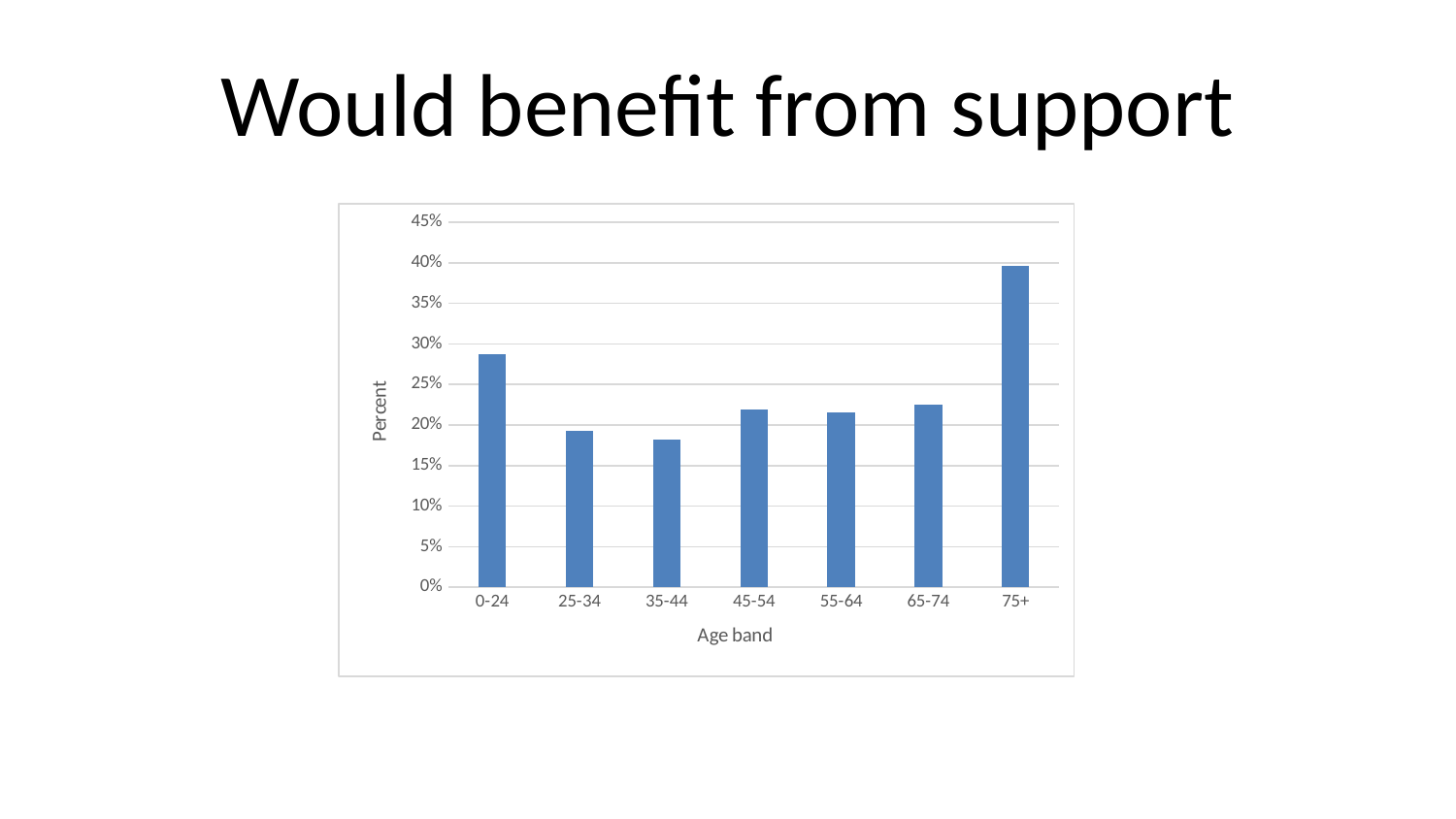
Is the value for the 35-44 age band greater or less than 20%? less Which has a higher percentage, the 0-24 age band or the 25-34 age band? 0-24 What is the title of the slide? Would benefit from support What kind of chart is shown on the slide? bar chart Which age band has the highest percentage in the chart? 75+ Which has a higher percentage, the 65-74 age band or the 35-44 age band? 65-74 What is the label on the x axis of the chart? Age band Which age band has the lowest percentage in the chart? 35-44 Is the value for the 75+ age band greater or less than 35%? greater How many age bands are shown on the x axis of the chart? 7 Is the value for the 0-24 age band greater or less than 25%? greater